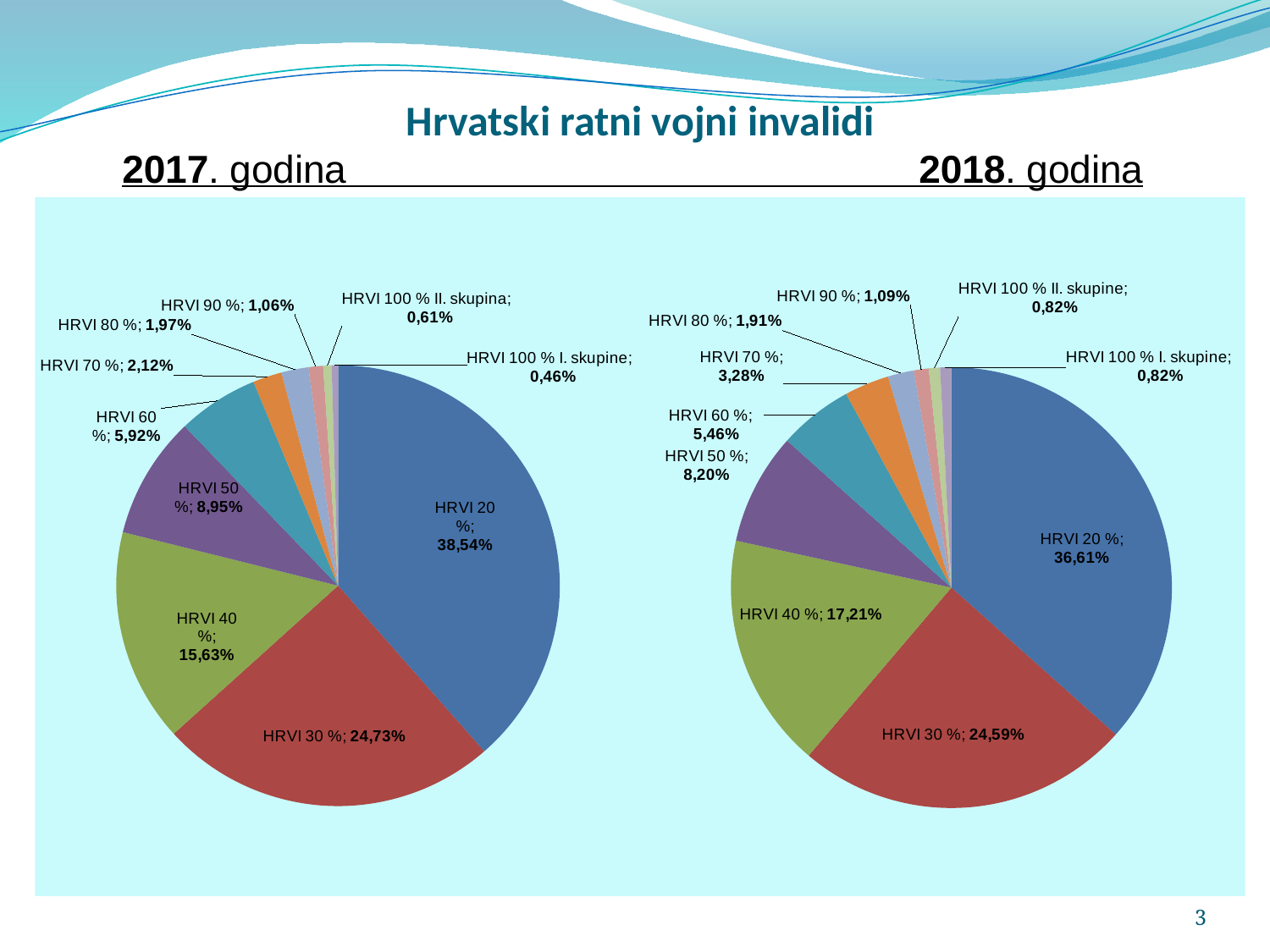
What type of chart is used for the 2017 data? Pie chart In the 2018 pie chart, which category has the largest slice? HRVI 20 % Which is larger: the HRVI 40 % share in the 2017 chart or in the 2018 chart? 2018 In the 2018 pie chart, what share is shown for HRVI 40 %? 17,21% What is the title shown above the two charts? Hrvatski ratni vojni invalidi In the 2018 pie chart, what share is shown for HRVI 70 %? 3,28% In the 2017 pie chart, which category has the largest slice? HRVI 20 % In the 2018 pie chart, what is the difference in percentage points between HRVI 40 % and HRVI 50 %? 9,01 In the 2017 pie chart, what share is shown for HRVI 20 %? 38,54% How many slices does the 2018 pie chart have? 10 In the 2017 pie chart, what is the difference in percentage points between HRVI 20 % and HRVI 30 %? 13,81 In the 2017 pie chart, which category has the smallest slice? HRVI 100 % I. skupine